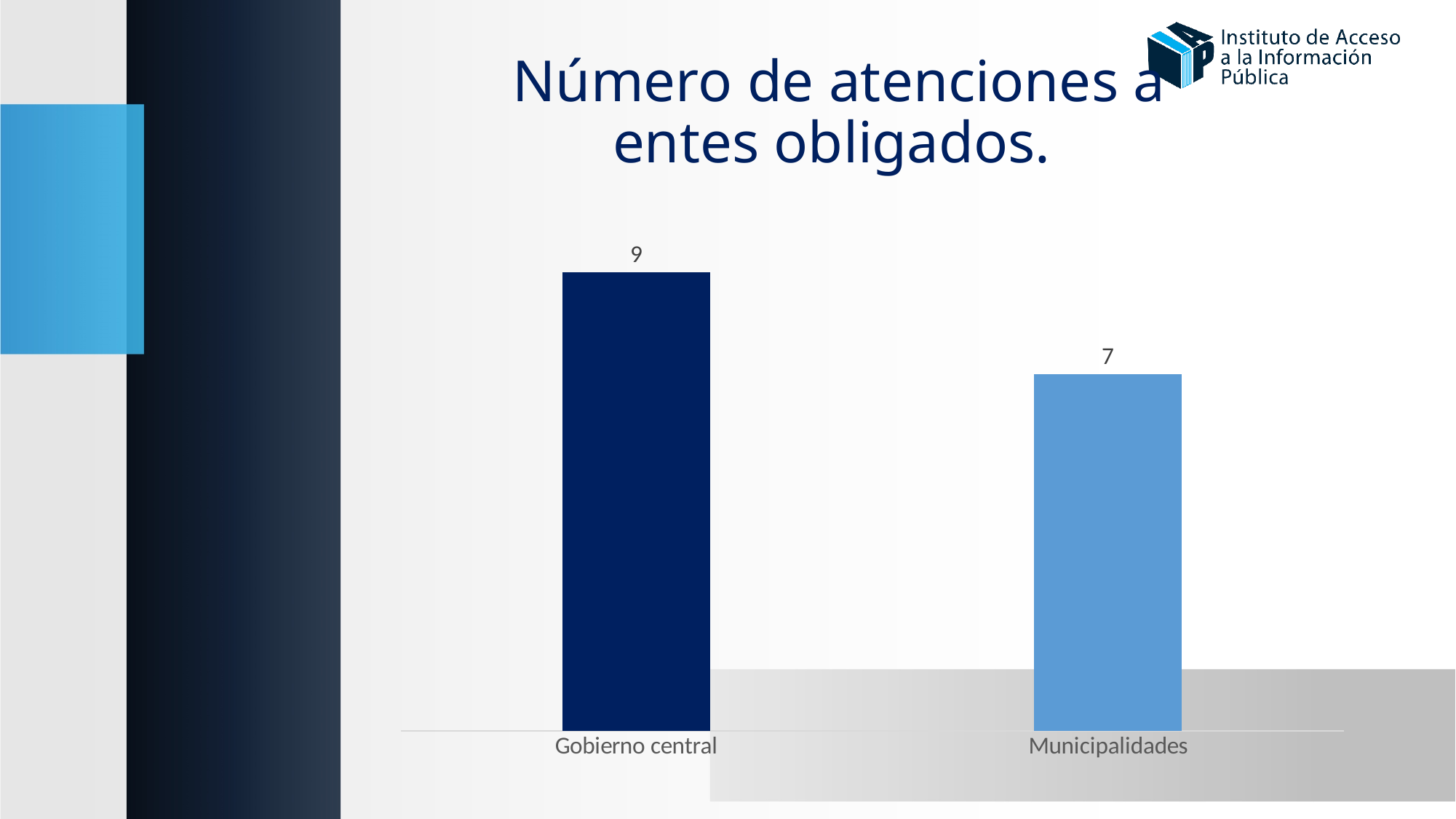
What is the title of the slide? Número de atenciones a entes obligados. Which category has the highest value? Gobierno central What colour is the bar for Municipalidades? light blue What is the difference between the values for Gobierno central and Municipalidades? 2 What is the total of the two values shown in the chart? 16 Which category has the lowest value? Municipalidades How many categories are shown in the chart? 2 What is the value for Gobierno central? 9 What is the value for Municipalidades? 7 What kind of chart is shown on the slide? bar chart Which is larger, the value for Gobierno central or the value for Municipalidades? Gobierno central